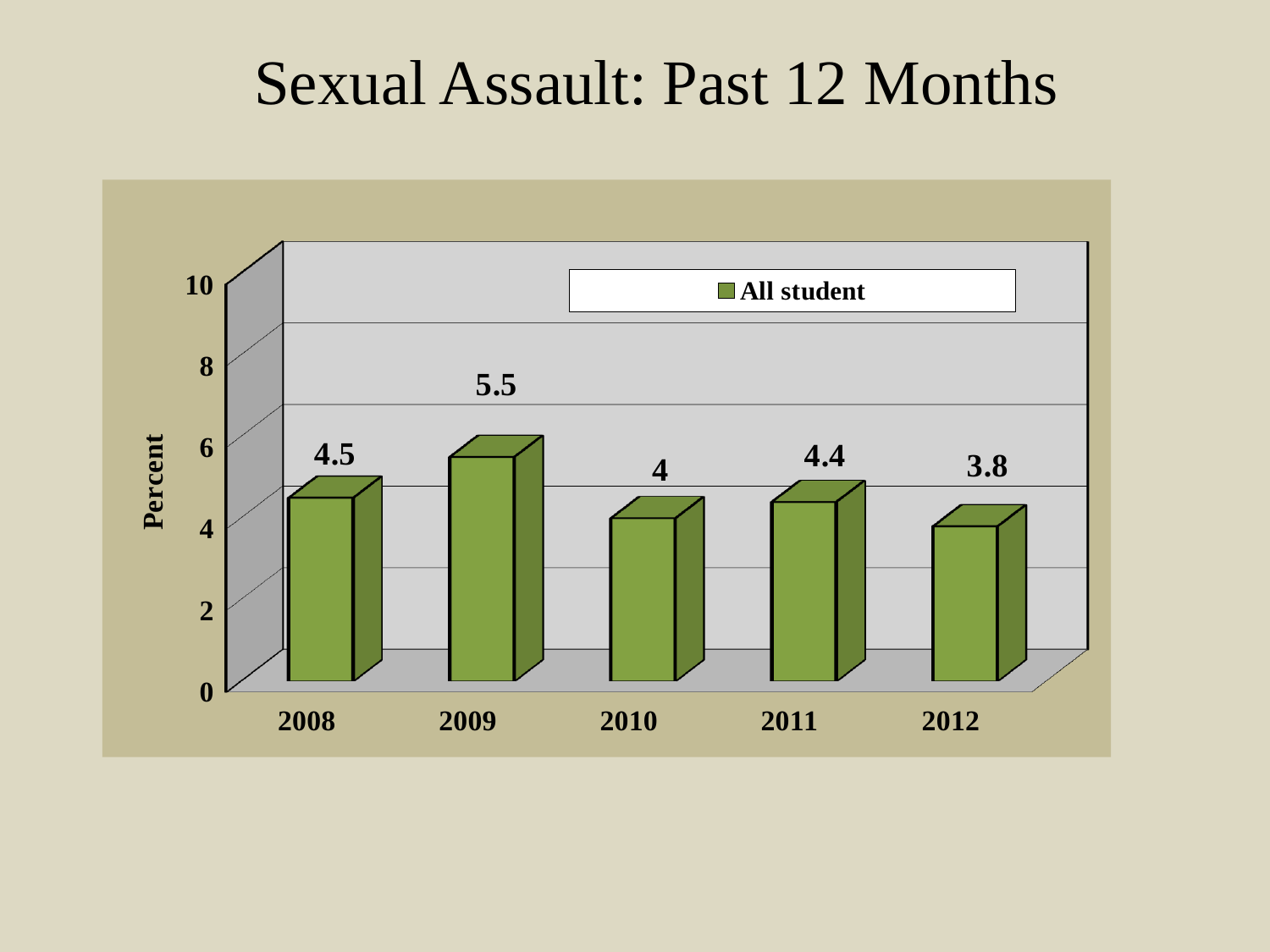
How many series does the legend list? 1 Which is larger, the value for 2008 or the value for 2010? 2008 How many years are shown on the x axis? 5 What is the label on the y axis? Percent Is the value for 2009 greater or less than 4? greater What is the difference between the values for 2009 and 2012? 1.7 Which year has the highest value? 2009 Which year has the lowest value? 2012 What is the value for 2009? 5.5 What kind of chart is shown? bar chart What is the value for 2010? 4 What is the value for 2012? 3.8